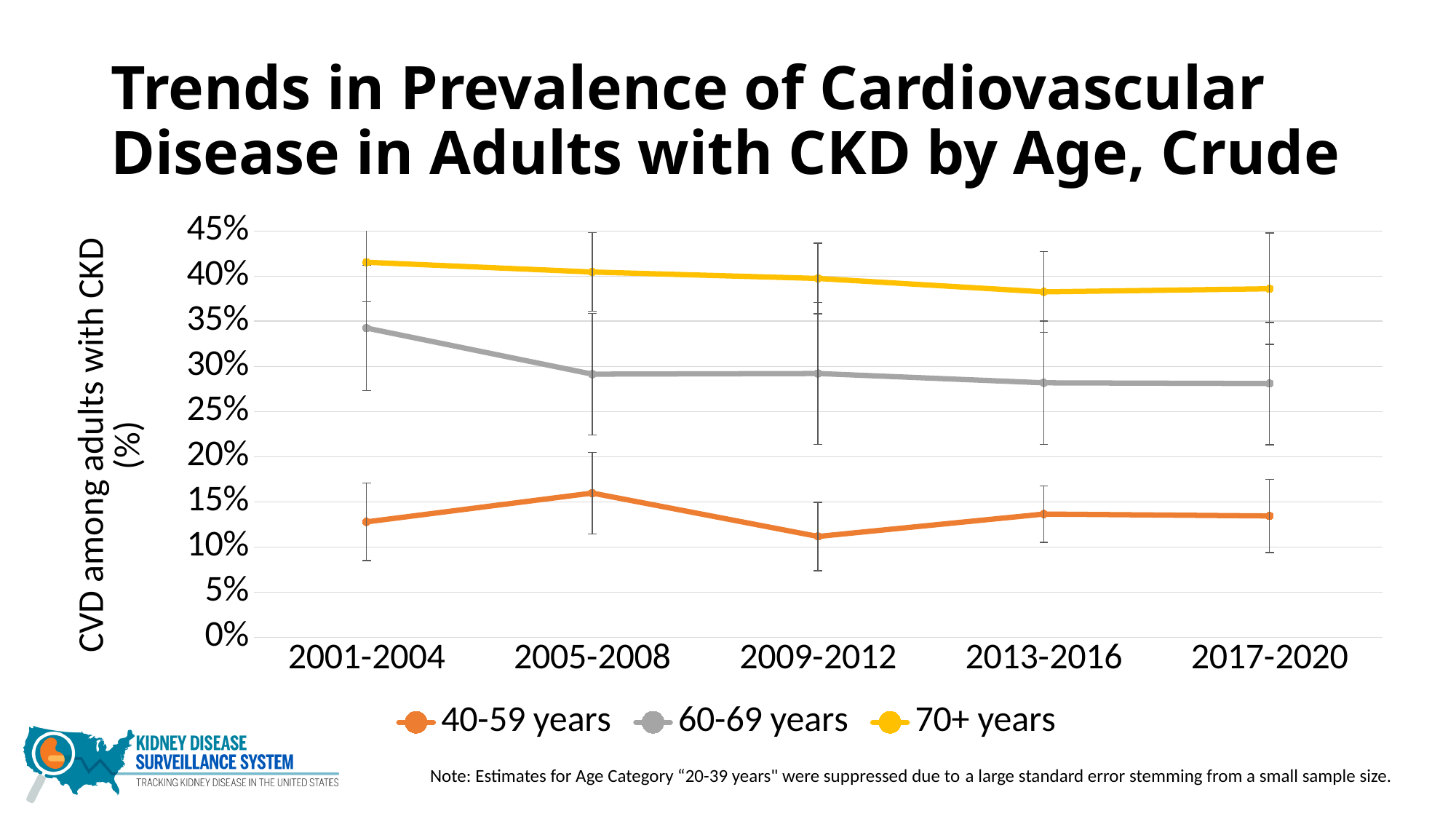
Is the value for 60-69 years in 2001-2004 greater or less than 30%? greater In which period is the value for 40-59 years highest? 2005-2008 In which period is the value for 60-69 years highest? 2001-2004 Is the value for 70+ years in 2013-2016 greater or less than 40%? less Which age group has the lowest CVD prevalence across all periods? 40-59 years What kind of chart is shown on the slide? Line chart Which age category was suppressed according to the note on the slide? 20-39 years In which period is the value for 40-59 years lowest? 2009-2012 Does the value for 60-69 years rise or fall from 2001-2004 to 2017-2020? fall How many time periods are shown on the x axis? 5 How many series does the legend list? 3 Which age group has the highest CVD prevalence across all periods? 70+ years